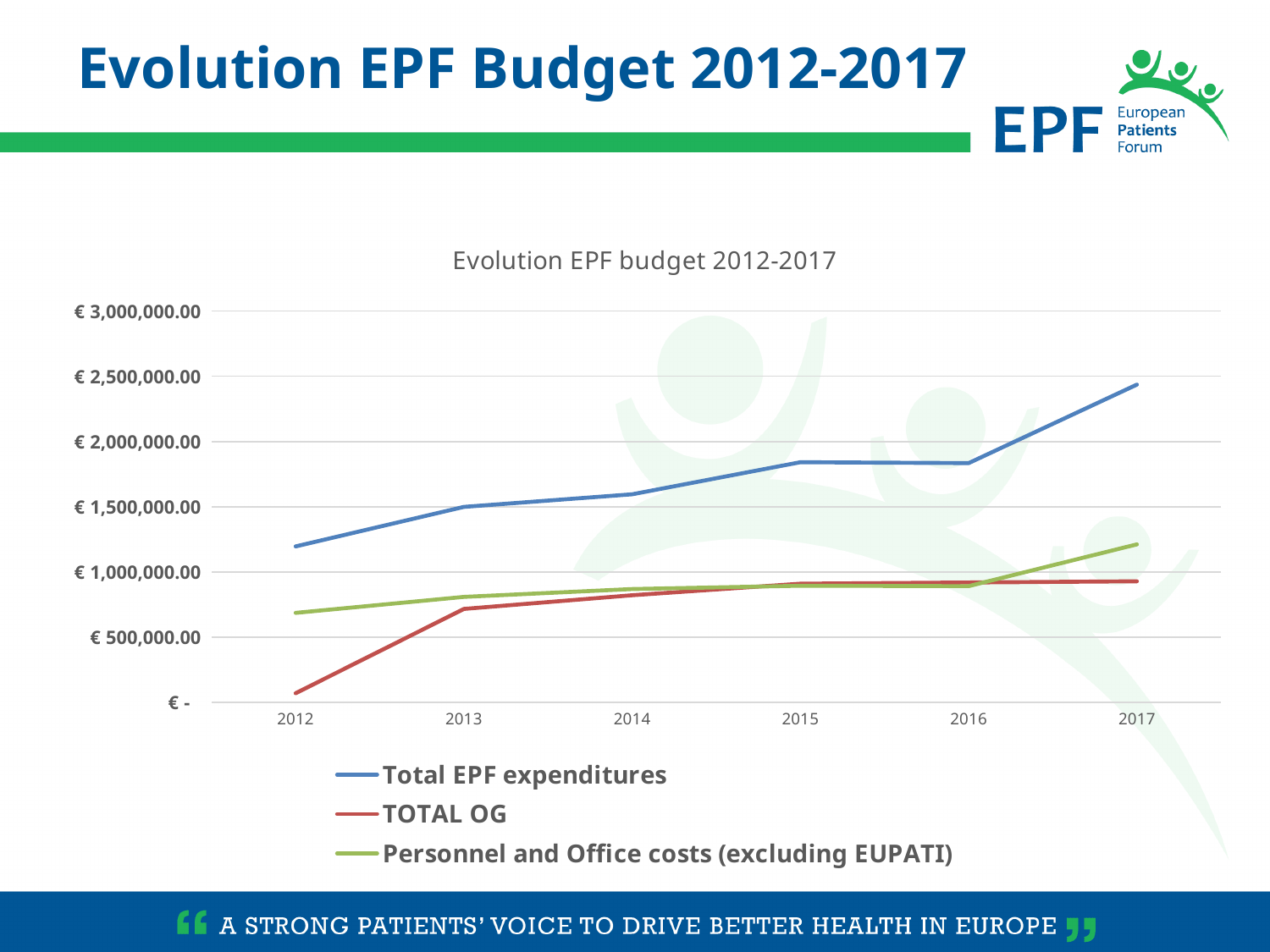
Is the value for Total EPF expenditures in 2017 greater or less than € 2,000,000.00? greater In which year is TOTAL OG lowest? 2012 In 2017, which is larger: Total EPF expenditures or TOTAL OG? Total EPF expenditures In which year is Total EPF expenditures highest? 2017 How many years are plotted along the x axis? 6 Is the value for Personnel and Office costs (excluding EUPATI) in 2017 greater or less than € 1,000,000.00? greater Which series is drawn in blue? Total EPF expenditures What is the title of the chart? Evolution EPF budget 2012-2017 How many series does the legend list? 3 What kind of chart is shown on the slide? Line chart Is the value for TOTAL OG in 2012 greater or less than € 500,000.00? less Does Total EPF expenditures rise or fall from 2012 to 2017? Rise